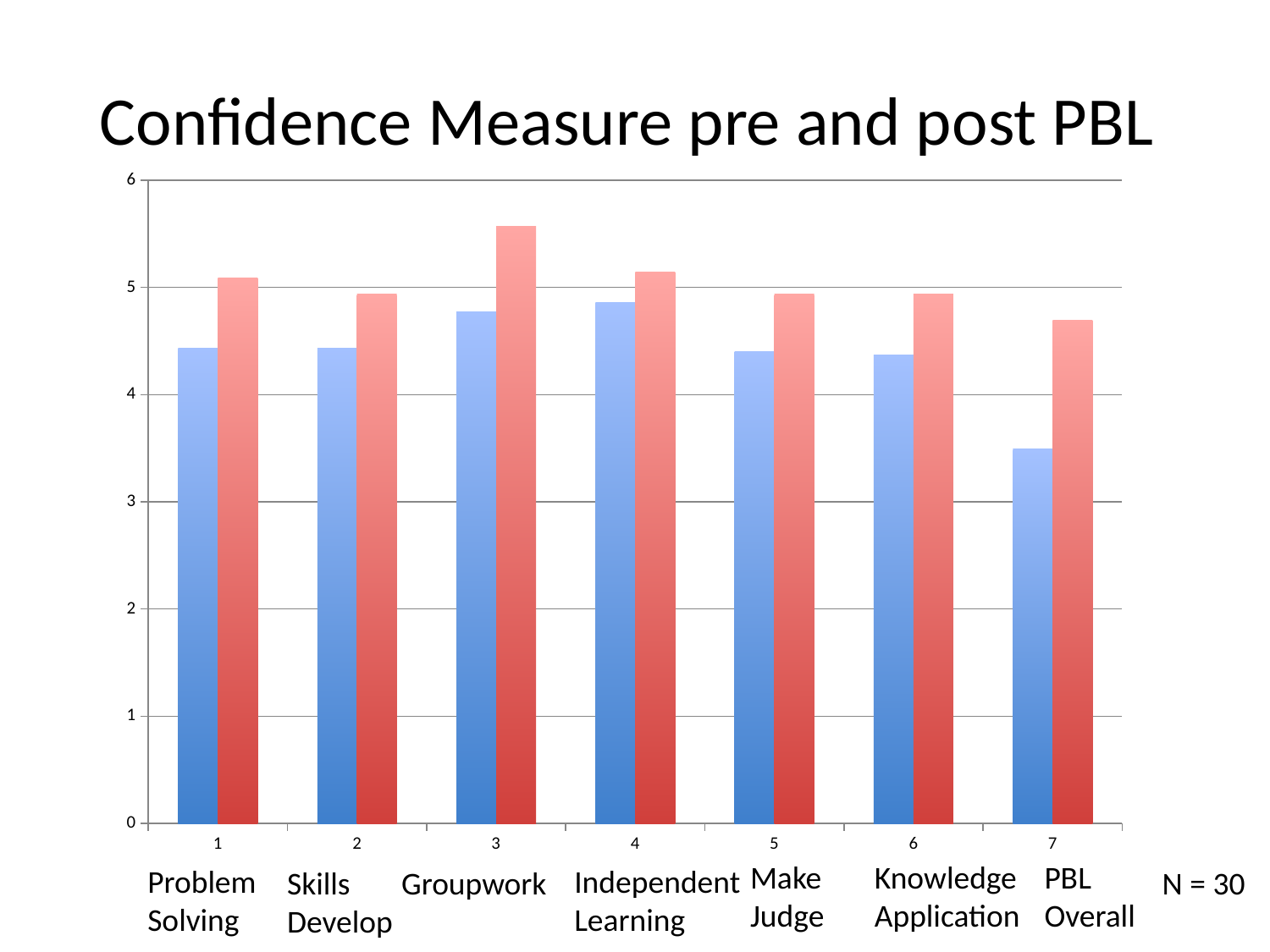
Which category has the tallest bar in the chart? Groupwork Which category has the shortest bar in the chart? PBL Overall Is the value of the red bar for PBL Overall greater or less than 5? less Which blue bar is taller, the one for Groupwork or the one for PBL Overall? Groupwork Is the value of the red bar for Groupwork greater or less than 5? greater Is the value of the blue bar for PBL Overall greater or less than 4? less How many categories are shown on the x axis of the chart? 7 What kind of chart is shown on the slide? bar chart What sample size (N) is stated next to the chart? N = 30 For Groupwork, which bar is taller, the blue bar or the red bar? the red bar What is the title of the chart? Confidence Measure pre and post PBL